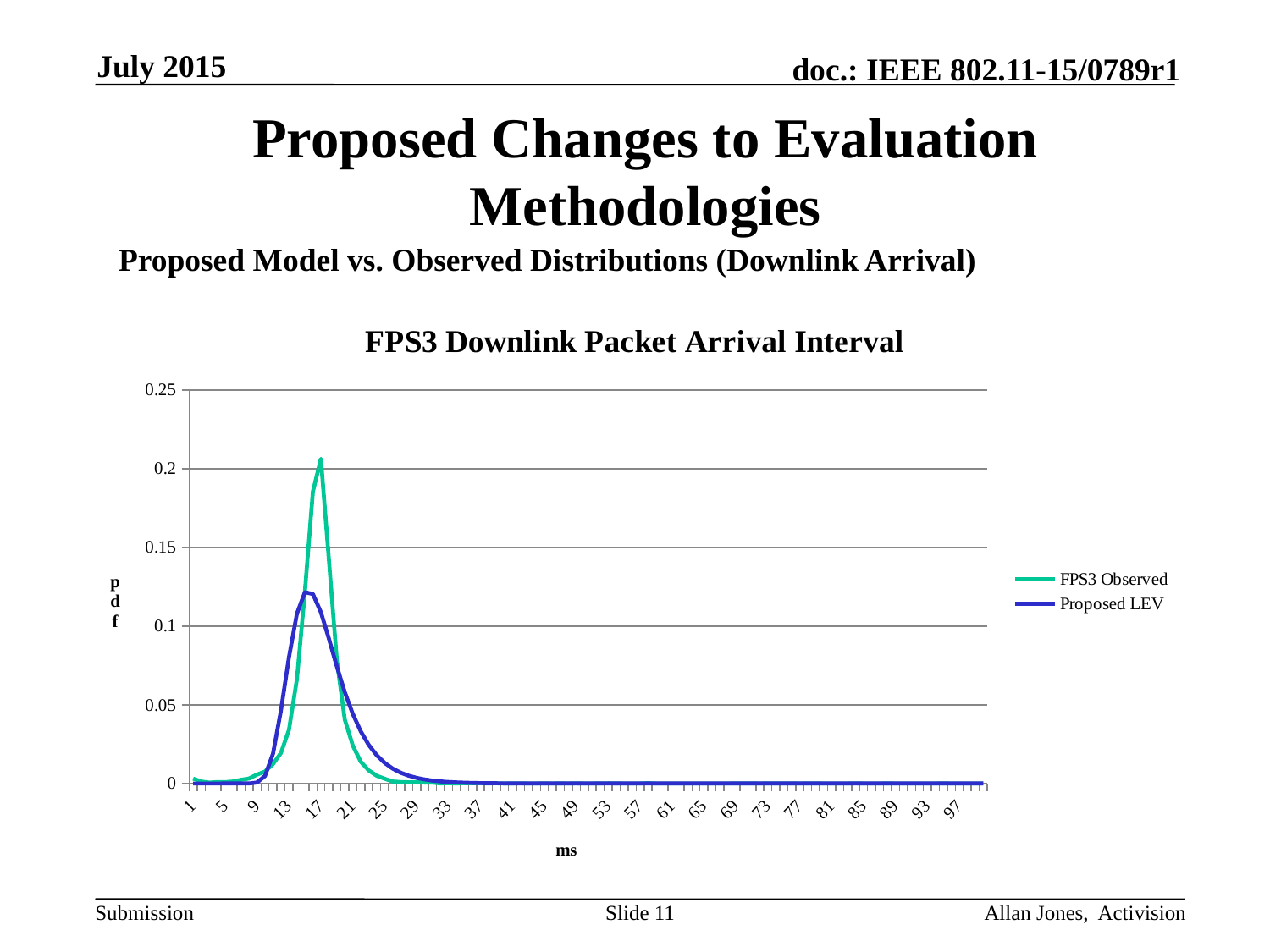
What is the title of the chart? FPS3 Downlink Packet Arrival Interval Which series reaches the higher peak, FPS3 Observed or Proposed LEV? FPS3 Observed Is the peak value of the Proposed LEV series greater or less than 0.15? less How many series does the legend list? 2 Is the peak value of the Proposed LEV series greater or less than 0.1? greater What are the two series named in the legend? FPS3 Observed and Proposed LEV After their peaks near 17 ms, do the values of both series rise or fall as ms increases? fall What is the highest value labelled on the y axis? 0.25 Is the value of the FPS3 Observed series at 41 ms greater or less than 0.05? less What kind of chart is shown on the slide? line chart